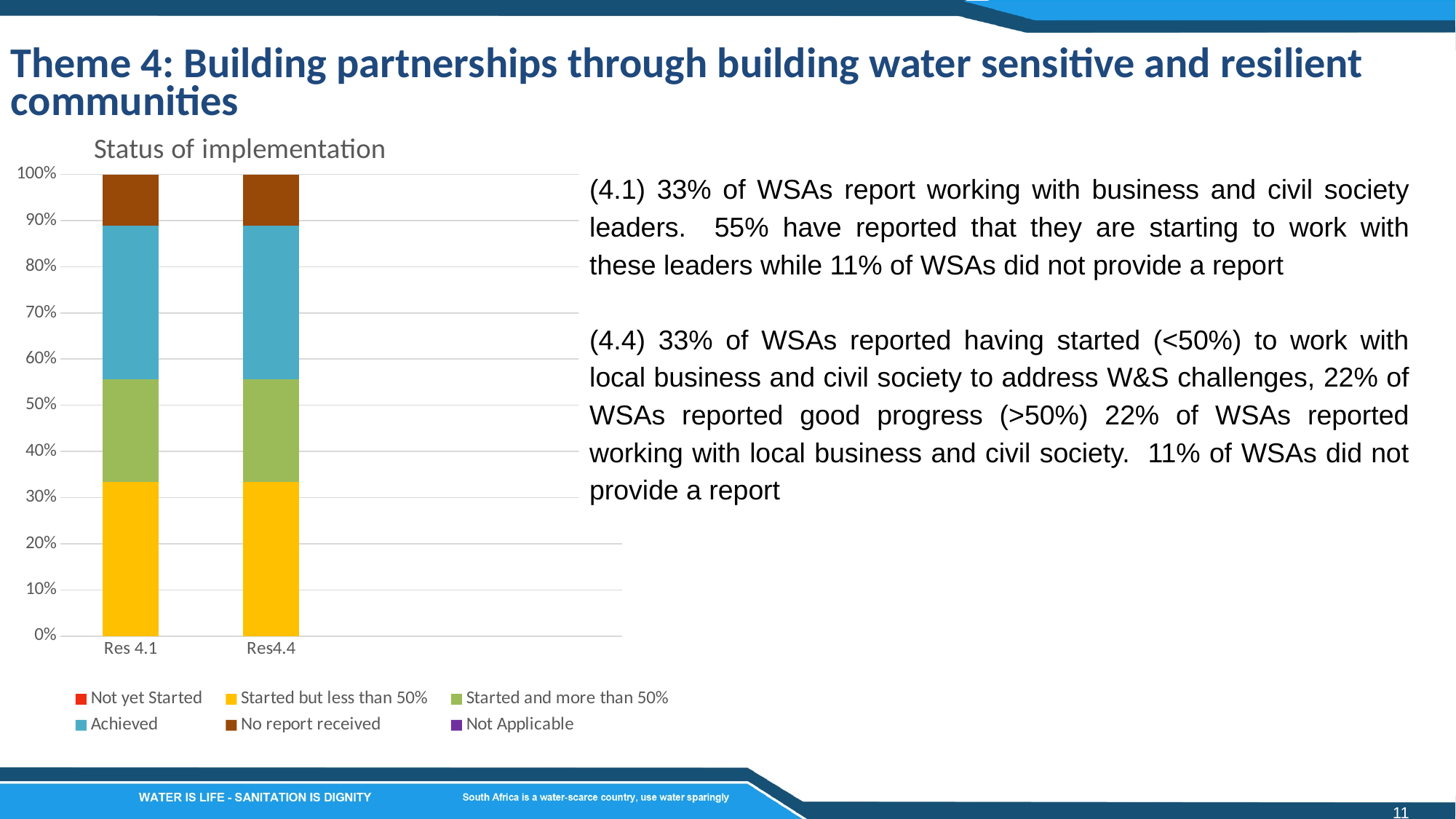
What is the title of the chart on the slide? Status of implementation What are the two category labels on the x axis of the "Status of implementation" chart? Res 4.1 and Res4.4 How many categories are plotted on the x axis of the "Status of implementation" chart? 2 What is the total height of the stacked bar for Res 4.1 in the "Status of implementation" chart? 100% In the "Status of implementation" chart, is the "Started and more than 50%" segment for Res 4.1 greater or less than 30%? less How many series does the legend of the "Status of implementation" chart list? 6 What kind of chart is shown under the title "Status of implementation"? stacked bar chart In the "Status of implementation" chart, is the "Started but less than 50%" segment for Res4.4 greater or less than 20%? greater In the "Status of implementation" chart, does the top of the "Achieved" segment for Res 4.1 reach greater or less than 80% on the axis? greater Which colour represents "Achieved" in the "Status of implementation" chart? blue